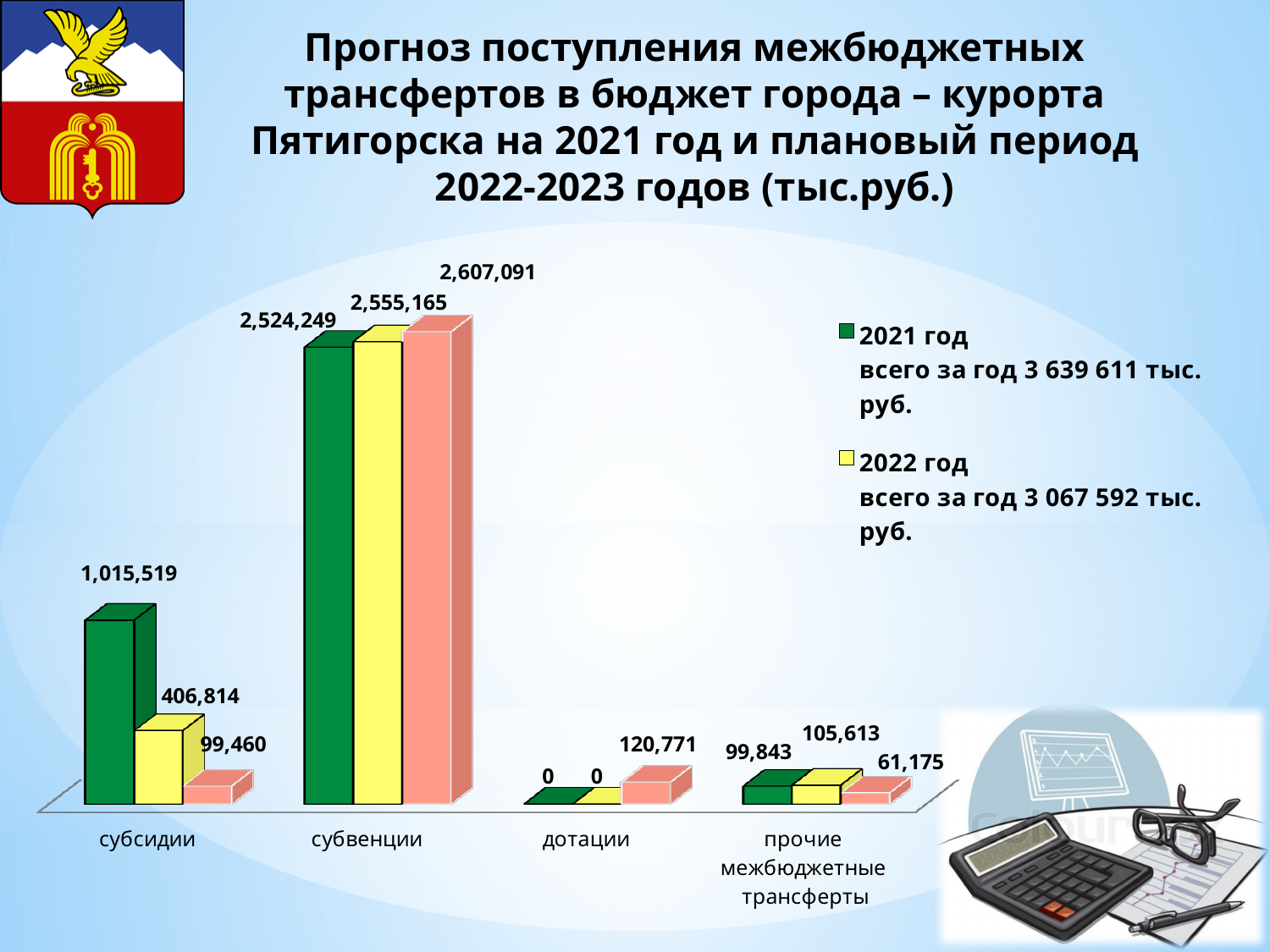
How many categories are shown on the x axis? 4 What is the value of the third (pink) bar for дотации? 120,771 What is the difference between the 2021 and 2022 values for субсидии? 608,705 What kind of chart is shown on the slide? bar chart Do the values for субсидии rise or fall from the 2021 bar to the 2023 bar? fall What is the 2021 value for субсидии? 1,015,519 Which category has the lowest 2022 value? дотации Which is larger for прочие межбюджетные трансферты: the 2021 value or the 2022 value? 2022 value According to the legend, what is the total for 2022 год? 3 067 592 тыс. руб. What is the 2022 value for субвенции? 2,555,165 What is the 2021 value for прочие межбюджетные трансферты? 99,843 Which category has the highest 2021 value? субвенции